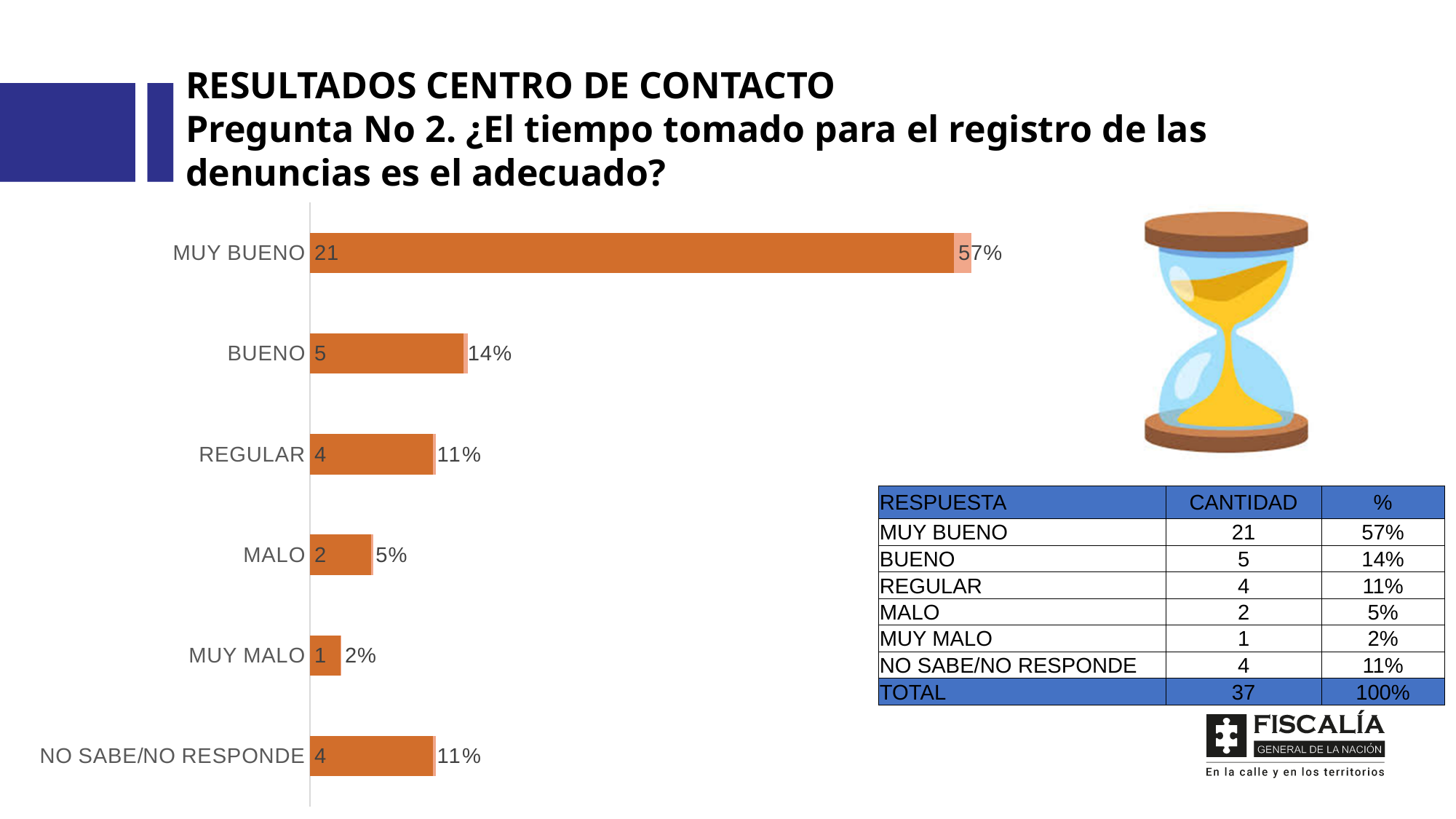
How many categories are shown in the bar chart? 6 What colour are the bars in the chart? Orange What percentage is shown for BUENO in the bar chart? 14% What is the count shown for MALO in the bar chart? 2 What kind of chart is shown on the slide? Bar chart What percentage is shown for NO SABE/NO RESPONDE in the bar chart? 11% Which category has the lowest value in the bar chart? MUY MALO What is the difference in count between MUY BUENO and BUENO? 16 What is the total count across all categories in the bar chart? 37 Which has a larger count, REGULAR or MALO? REGULAR What is the count shown for MUY BUENO in the bar chart? 21 Which category has the highest value in the bar chart? MUY BUENO